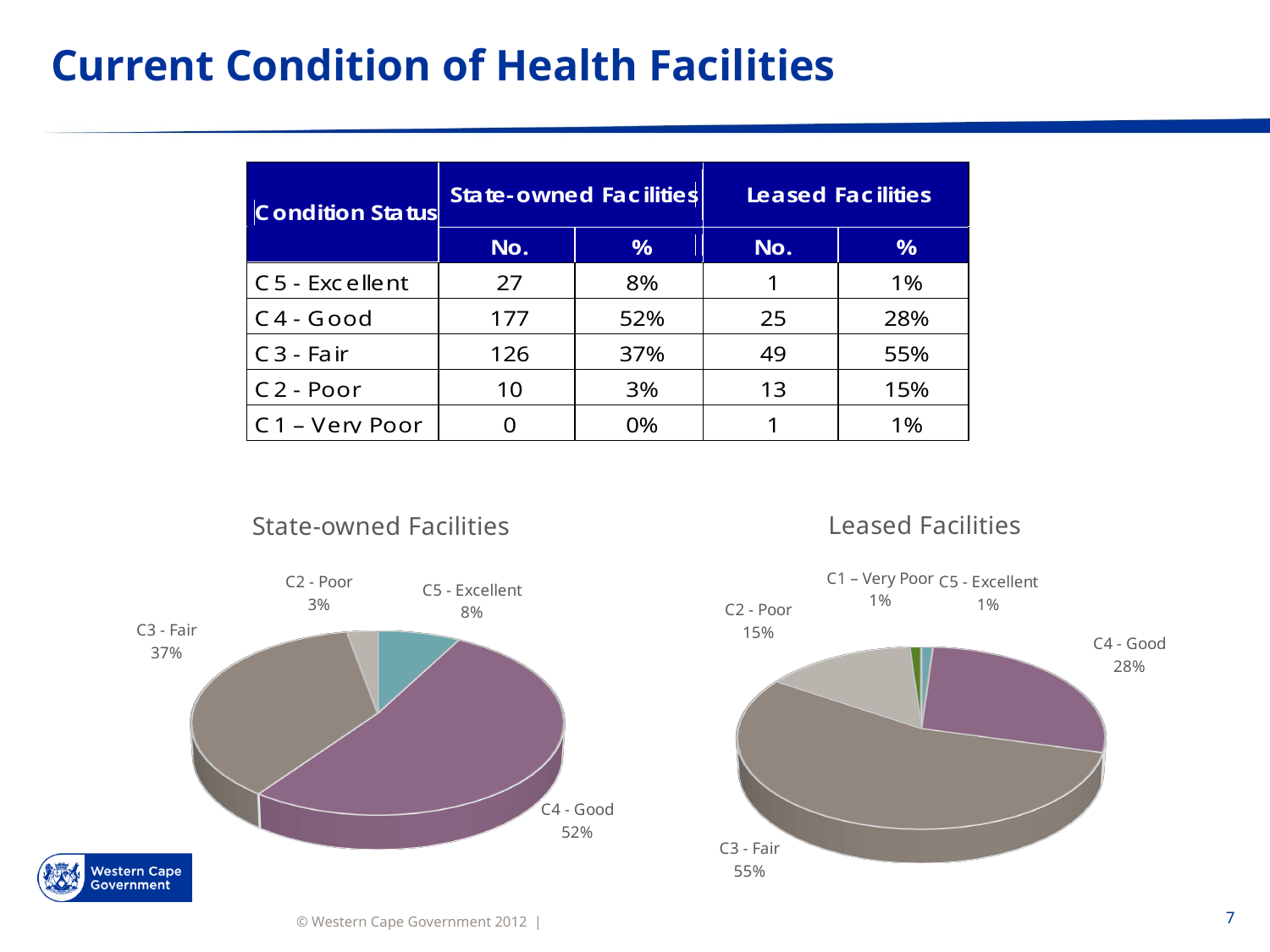
In the Leased Facilities pie chart, what is the difference between the shares of C3 - Fair and C4 - Good? 27% In the State-owned Facilities pie chart, which category has the largest share? C4 - Good In the State-owned Facilities pie chart, what share does C4 - Good have? 52% In the Leased Facilities pie chart, what share does C2 - Poor have? 15% In the Leased Facilities pie chart, what share does C3 - Fair have? 55% What kind of chart is the State-owned Facilities chart? pie chart In the State-owned Facilities pie chart, what is the difference between the shares of C4 - Good and C3 - Fair? 15% In the Leased Facilities pie chart, which is larger, C4 - Good or C2 - Poor? C4 - Good How many slices are labelled in the Leased Facilities pie chart? 5 In the Leased Facilities pie chart, which category has the largest share? C3 - Fair In the State-owned Facilities pie chart, which category has the smallest share? C2 - Poor